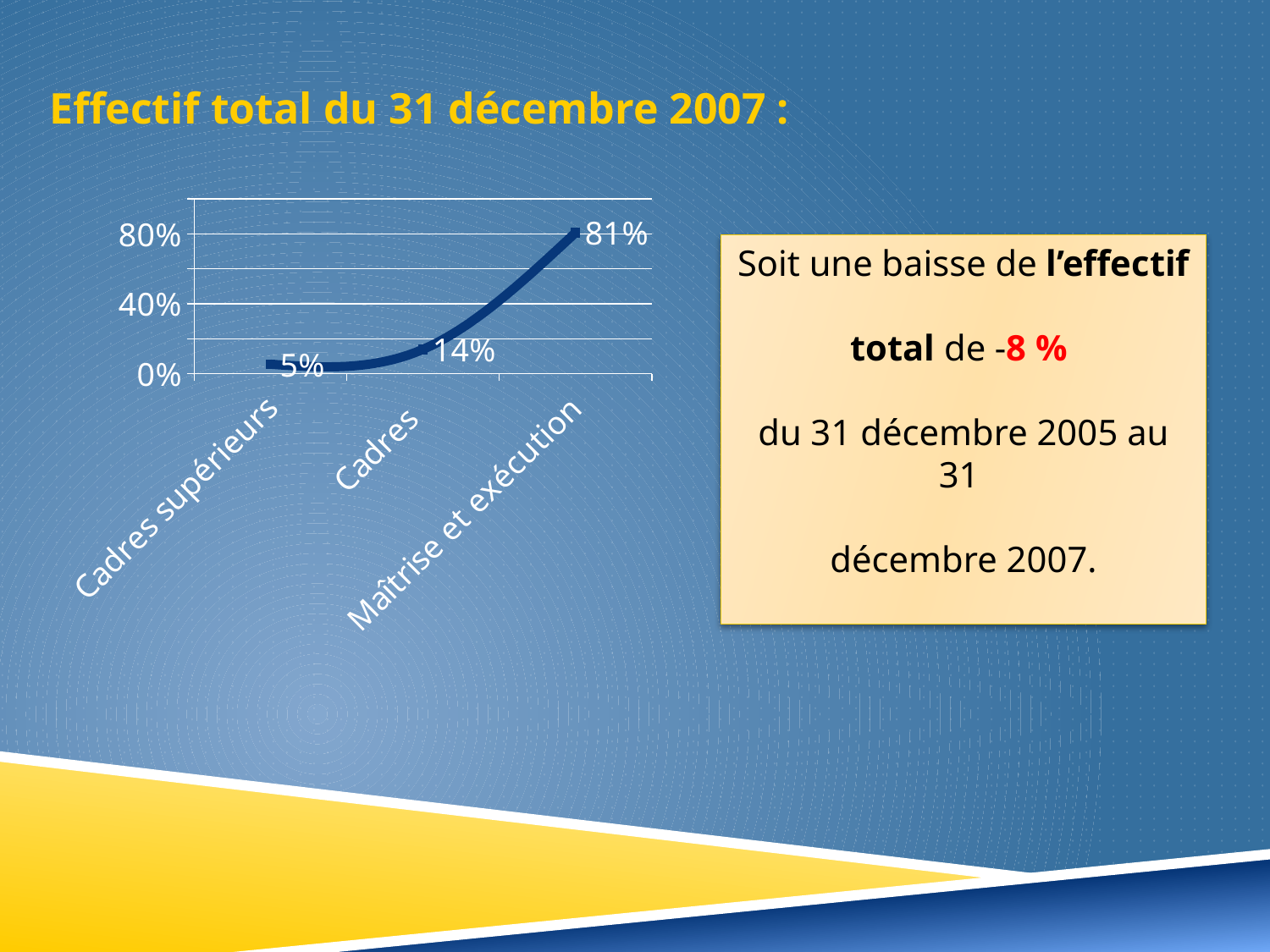
How many categories are shown on the x axis? 3 What is the difference between the values for Cadres and Cadres supérieurs? 9% What is the value for Maîtrise et exécution? 81% Which is larger, the value for Cadres or the value for Cadres supérieurs? Cadres Which category has the lowest value? Cadres supérieurs What is the value for Cadres? 14% Is the value for Maîtrise et exécution greater or less than 40%? greater Which category has the highest value? Maîtrise et exécution What is the difference between the values for Maîtrise et exécution and Cadres? 67% Do the values rise or fall from left to right along the x axis? Rise What is the value for Cadres supérieurs? 5% What kind of chart is shown on the slide? Line chart